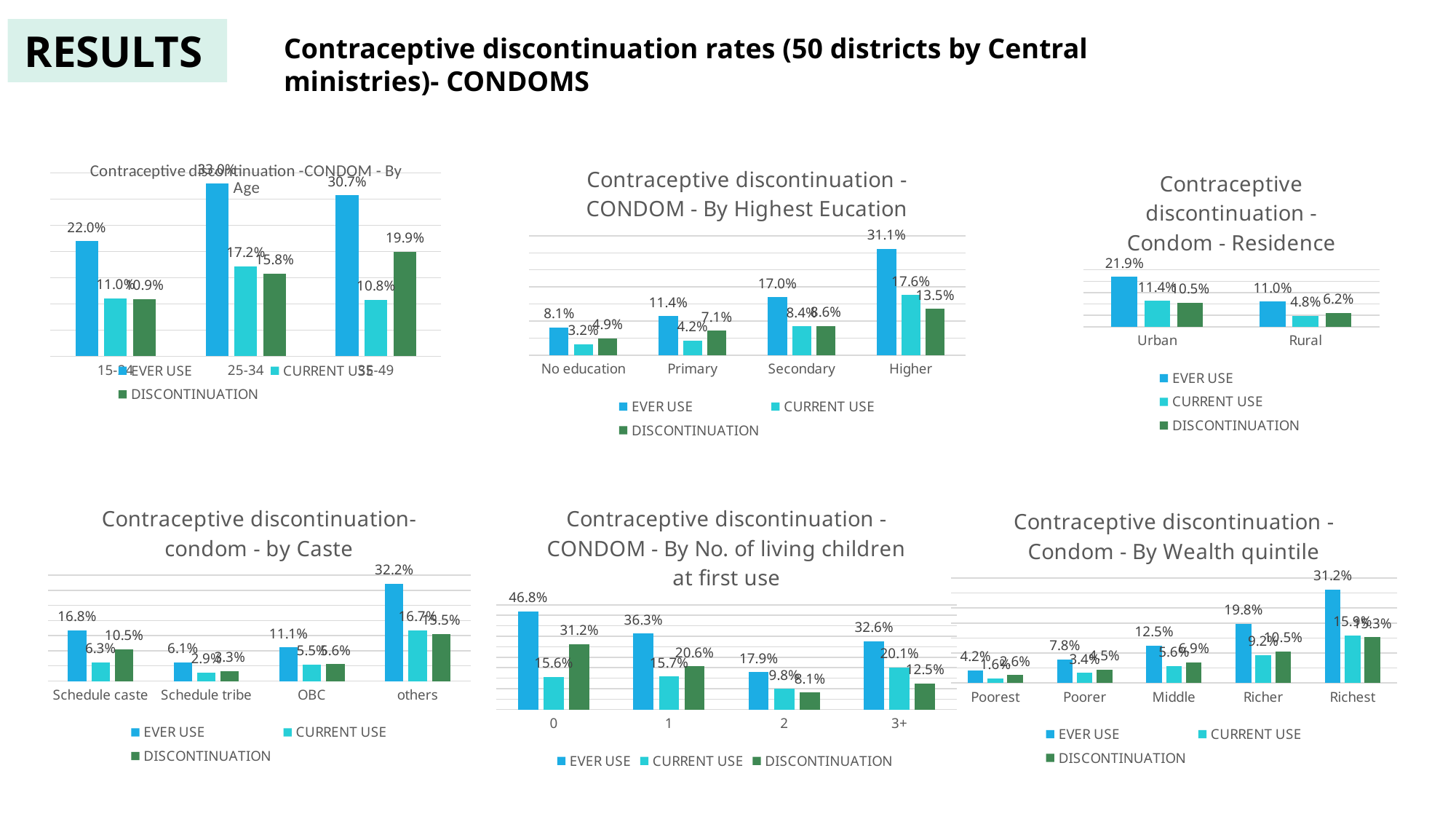
In the 'Contraceptive discontinuation - CONDOM - By No. of living children at first use' chart, what is the difference between the DISCONTINUATION values for 0 and 2? 23.1% In the 'Contraceptive discontinuation - CONDOM - By Highest Eucation' chart, do the EVER USE values rise or fall from No education to Higher? Rise In the 'Contraceptive discontinuation - CONDOM - By No. of living children at first use' chart, which category has the highest EVER USE value? 0 How many series does the legend of the 'Contraceptive discontinuation - CONDOM - By Highest Eucation' chart list? 3 In the 'Contraceptive discontinuation- condom - by Caste' chart, what is the difference between the EVER USE values for others and Schedule tribe? 26.1% In the 'Contraceptive discontinuation -CONDOM - By Age' chart, what is the DISCONTINUATION value for 35-49? 19.9% In the 'Contraceptive discontinuation - Condom - By Wealth quintile' chart, which category has the lowest CURRENT USE value? Poorest In the 'Contraceptive discontinuation - CONDOM - By Highest Eucation' chart, what is the EVER USE value for Higher? 31.1% In the 'Contraceptive discontinuation - Condom - Residence' chart, which is larger: the EVER USE value for Urban or for Rural? Urban How many categories are shown on the x axis of the 'Contraceptive discontinuation - Condom - By Wealth quintile' chart? 5 In the 'Contraceptive discontinuation - Condom - Residence' chart, what is the DISCONTINUATION value for Rural? 6.2% What kind of chart is the 'Contraceptive discontinuation - Condom - Residence' chart? Bar chart